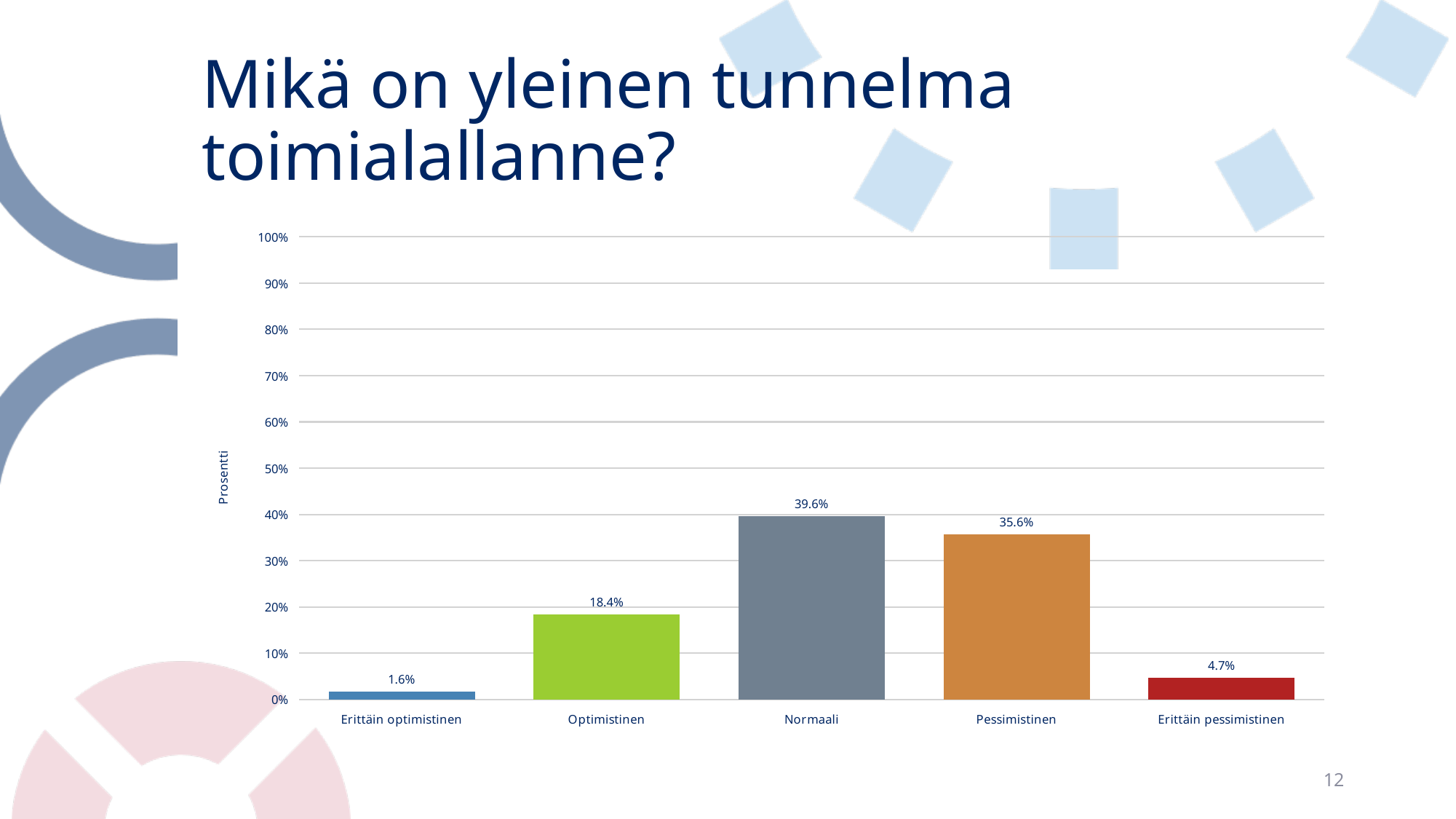
What is the value for Optimistinen? 18.4% How many categories are shown on the x axis? 5 What is the value for Erittäin pessimistinen? 4.7% What is the difference between the values for Normaali and Pessimistinen? 4.0% What is the value for Erittäin optimistinen? 1.6% Which is larger, the value for Optimistinen or the value for Erittäin pessimistinen? Optimistinen What kind of chart is shown on the slide? bar chart What is the label of the vertical axis? Prosentti Which category has the highest value? Normaali What is the value for Normaali? 39.6% Is the value for Pessimistinen greater or less than 30%? greater Which category has the lowest value? Erittäin optimistinen